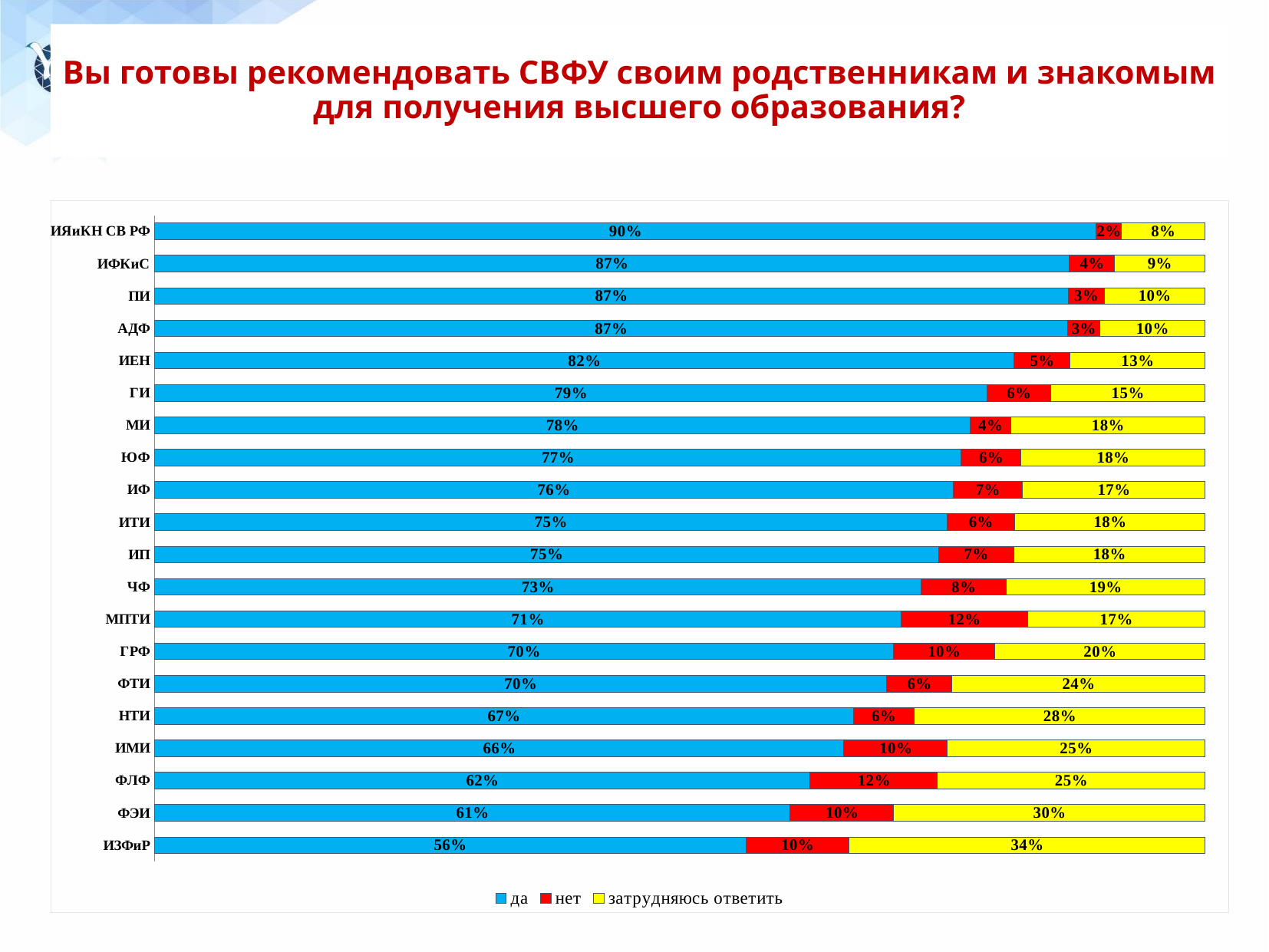
Which colour represents the "нет" series? Red What is the "затрудняюсь ответить" value for НТИ? 28% Which category has the highest "затрудняюсь ответить" value? ИЗФиР Which category has the highest "да" value? ИЯиКН СВ РФ What percentage of respondents from ИЗФиР answered "да"? 56% How many series does the legend list? 3 What is the difference between the "да" values for ИЯиКН СВ РФ and ИЗФиР? 34% What is the "нет" value for МПТИ? 12% Which has a larger "затрудняюсь ответить" value, ФЭИ or ФЛФ? ФЭИ Which category has the lowest "да" value? ИЗФиР How many categories (institutes) are shown in the chart? 20 What kind of chart is shown on the slide? Stacked bar chart